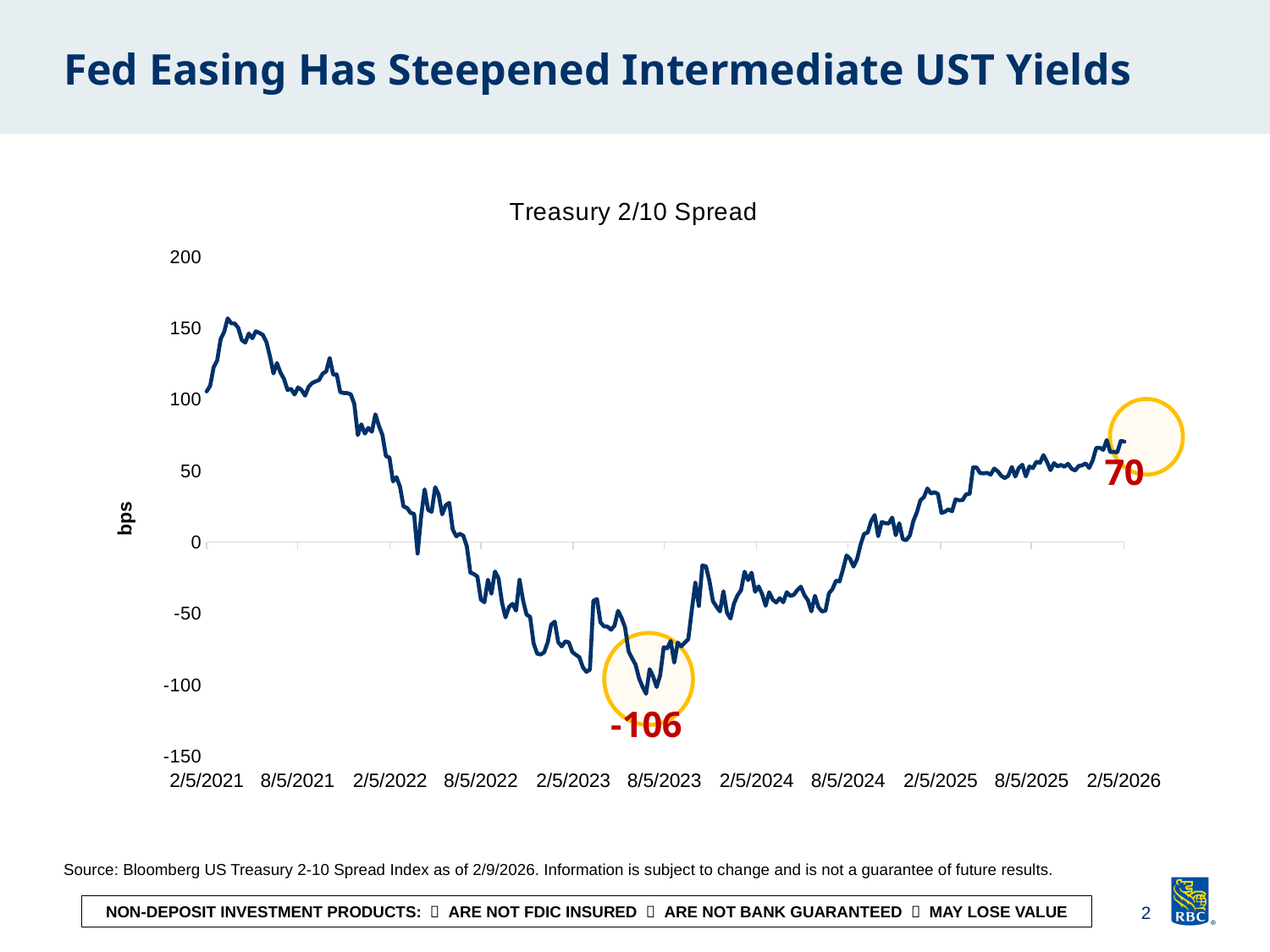
Does the spread generally rise or fall between 8/5/2023 and 2/5/2026? rise Does the spread generally rise or fall between 2/5/2021 and 8/5/2022? fall What is the title of the chart? Treasury 2/10 Spread What value is annotated at the end of the line near 2/5/2026? 70 What is the difference between the annotated value 70 and the annotated low of -106? 176 Which annotated value is larger, the one near 8/5/2023 or the one near 2/5/2026? the one near 2/5/2026 (70) What is the lowest value annotated on the Treasury 2/10 Spread line? -106 Is the value of the spread at 2/5/2025 greater or less than 0? greater Is the value of the spread at 2/5/2022 greater or less than 100? less What unit is shown on the y-axis label of the chart? bps What kind of chart is shown on the slide? line chart Is the value of the spread at 2/5/2024 greater or less than 0? less